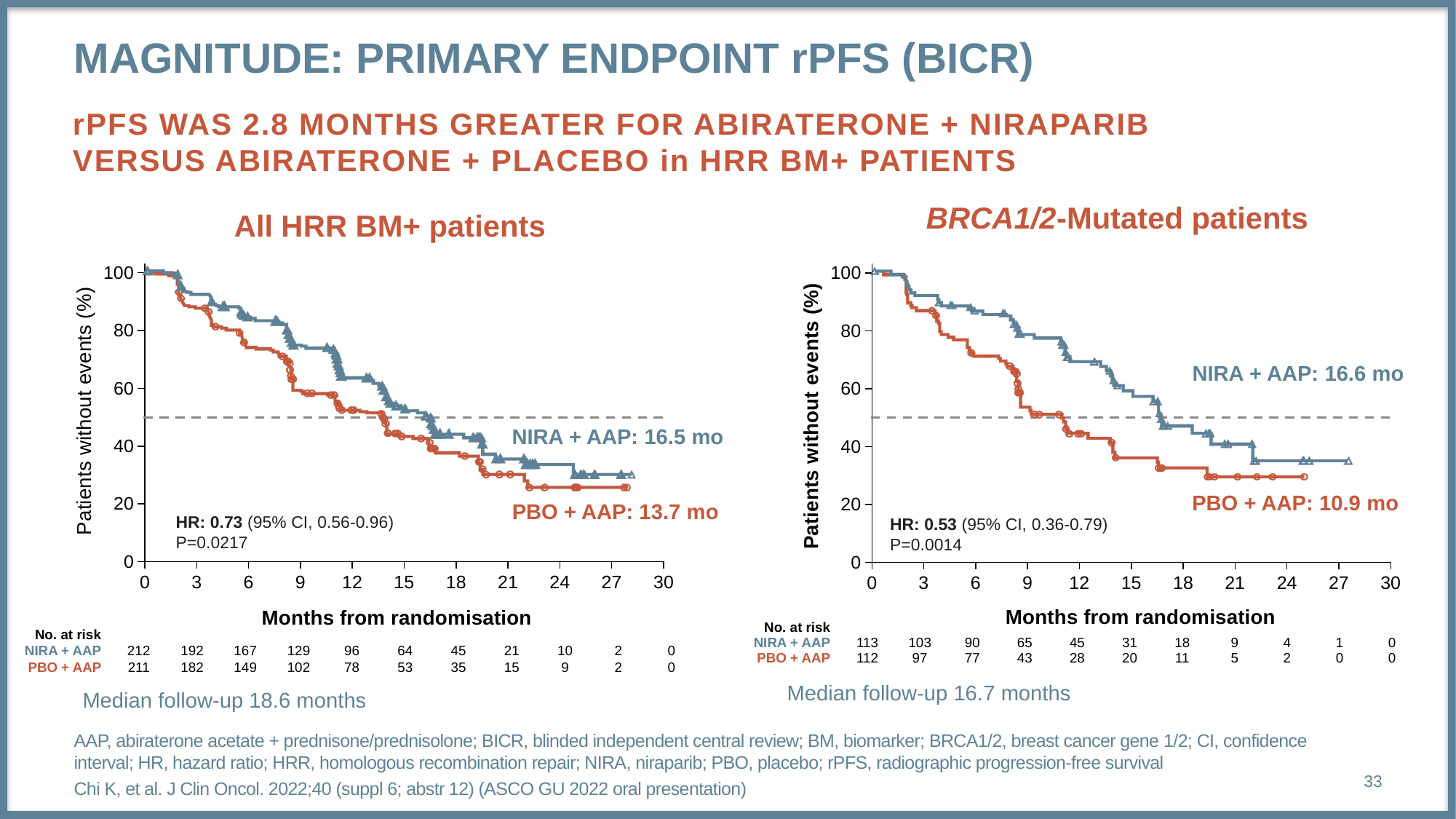
In the 'All HRR BM+ patients' chart, which arm has the longer median rPFS, NIRA + AAP or PBO + AAP? NIRA + AAP In the 'All HRR BM+ patients' chart, how many NIRA + AAP patients were at risk at 12 months? 96 In the 'All HRR BM+ patients' chart, what is the median rPFS for NIRA + AAP? 16.5 mo In the 'BRCA1/2-Mutated patients' chart, what is the median rPFS for PBO + AAP? 10.9 mo In the 'BRCA1/2-Mutated patients' chart, how many PBO + AAP patients were at risk at 9 months? 43 In the 'BRCA1/2-Mutated patients' chart, what P value is shown? P=0.0014 What kind of chart is the 'All HRR BM+ patients' chart? line chart In the 'All HRR BM+ patients' chart, what is the median rPFS for PBO + AAP? 13.7 mo What is the x-axis label of the 'BRCA1/2-Mutated patients' chart? Months from randomisation In the 'All HRR BM+ patients' chart, what hazard ratio is shown? 0.73 In the 'BRCA1/2-Mutated patients' chart, is the PBO + AAP curve at 18 months greater or less than 40%? less In the 'BRCA1/2-Mutated patients' chart, what is the difference in median rPFS between NIRA + AAP and PBO + AAP? 5.7 mo